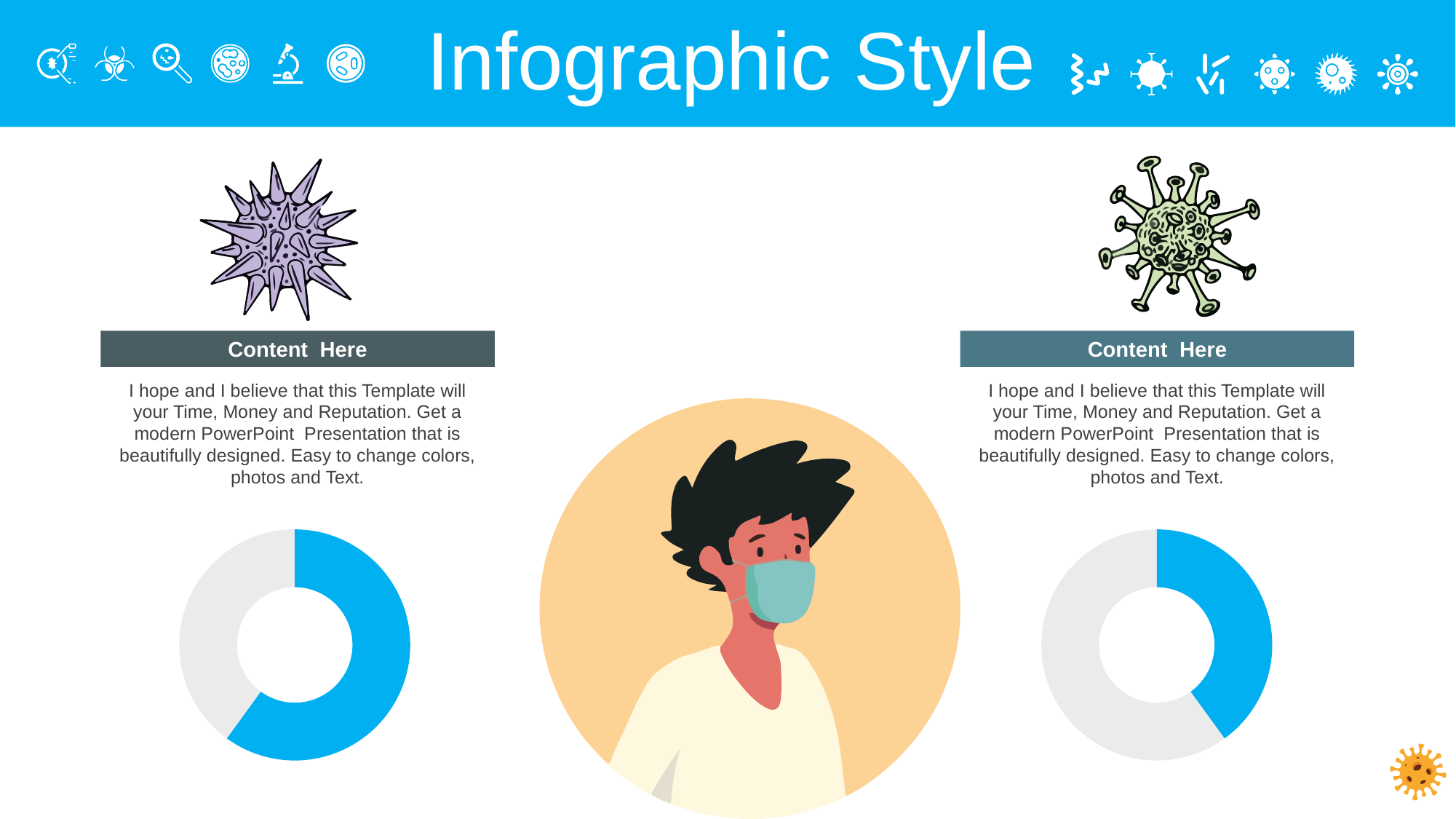
What kind of chart is shown on the right side of the slide? Doughnut chart Does either doughnut chart display a legend? No What kind of chart is shown on the left side of the slide? Doughnut chart What two colours are used for the slices in the doughnut charts? Blue and grey How many doughnut charts are on the slide? 2 How many slices does the left doughnut chart have? 2 Which doughnut chart has the larger blue slice, the left one or the right one? Left How many slices does the right doughnut chart have? 2 In the left doughnut chart, which slice is larger, the blue one or the grey one? Blue